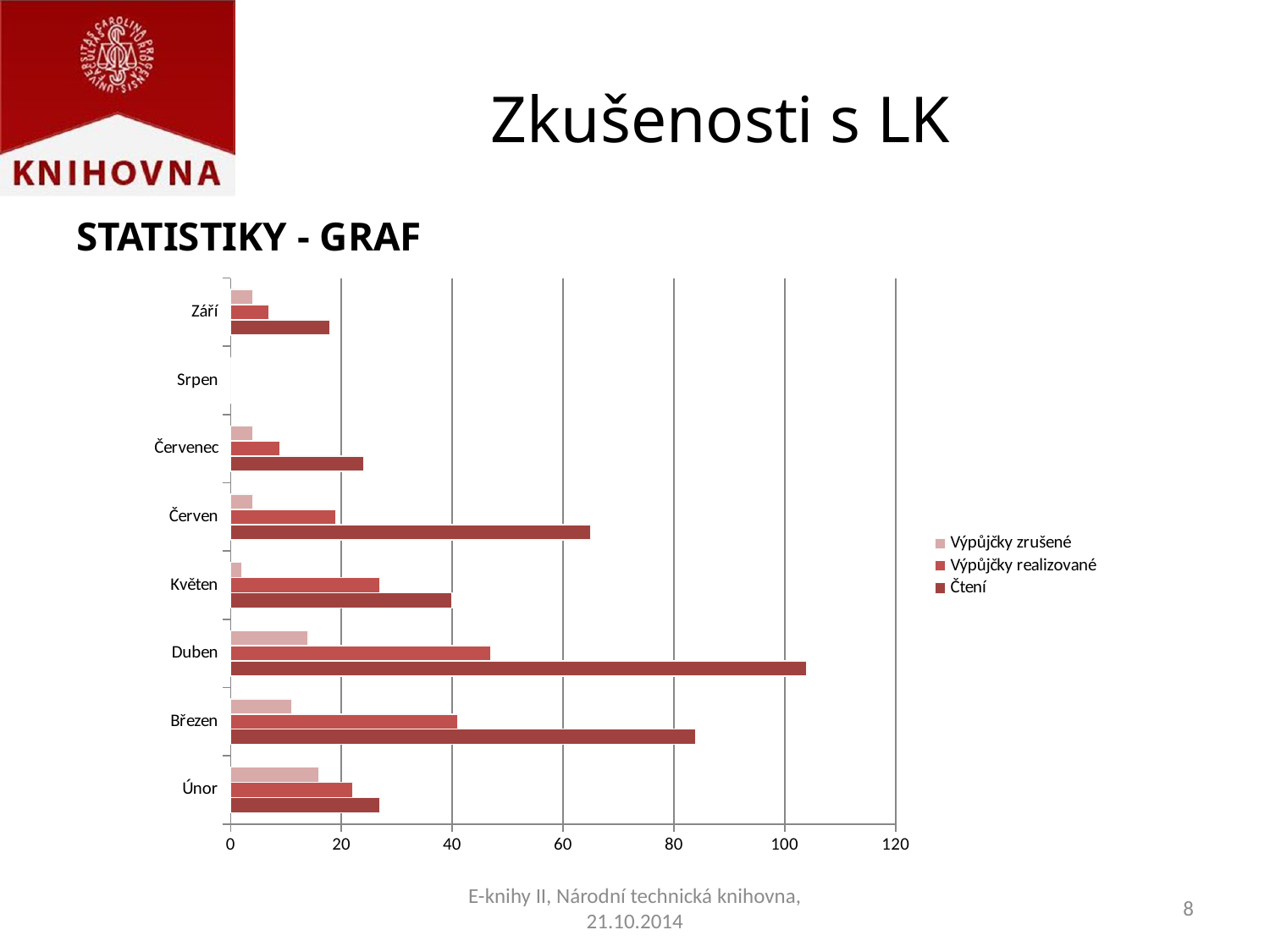
Is the Čtení value for Duben greater or less than 100? greater What are the three series named in the legend? Výpůjčky zrušené, Výpůjčky realizované, Čtení Is the Čtení value for Červen greater or less than 60? greater Which month shows no bars at all (zero values for every series)? Srpen How many series does the legend list? 3 How many months (categories) are shown on the chart? 8 What kind of chart is shown on the slide? bar chart Which month has the highest value for Čtení? Duben Is the Čtení value for Březen greater or less than 80? greater Which month has the highest value for Výpůjčky zrušené? Únor Which is larger: the Čtení value for Březen or the Čtení value for Květen? Březen